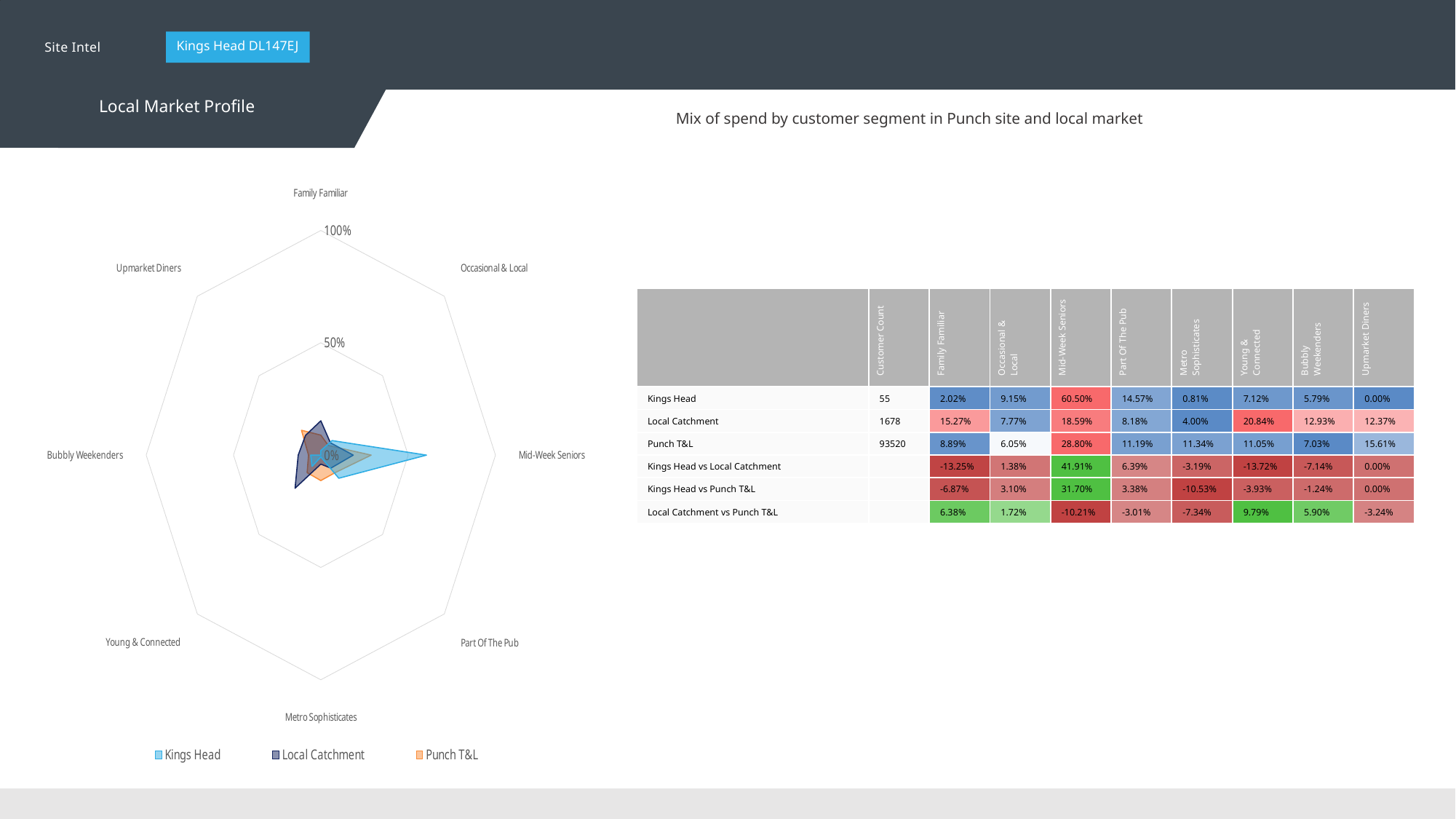
Which customer segment has the lowest value for Kings Head? Upmarket Diners Is the Kings Head value for Mid-Week Seniors greater or less than 50%? greater What is the difference between Kings Head and Local Catchment for Mid-Week Seniors? 41.91% What is the outermost percentage label shown on the radar chart's axis? 100% Which customer segment has the highest value for Kings Head? Mid-Week Seniors What is the Kings Head value for Mid-Week Seniors? 60.50% What is the Punch T&L value for Upmarket Diners? 15.61% For Mid-Week Seniors, which is larger: Kings Head or Local Catchment? Kings Head How many series does the legend of the radar chart list? 3 Which customer segment has the highest value for Punch T&L? Mid-Week Seniors How many customer segments (axes) does the radar chart have? 8 What kind of chart is shown on the left of the slide? Radar chart